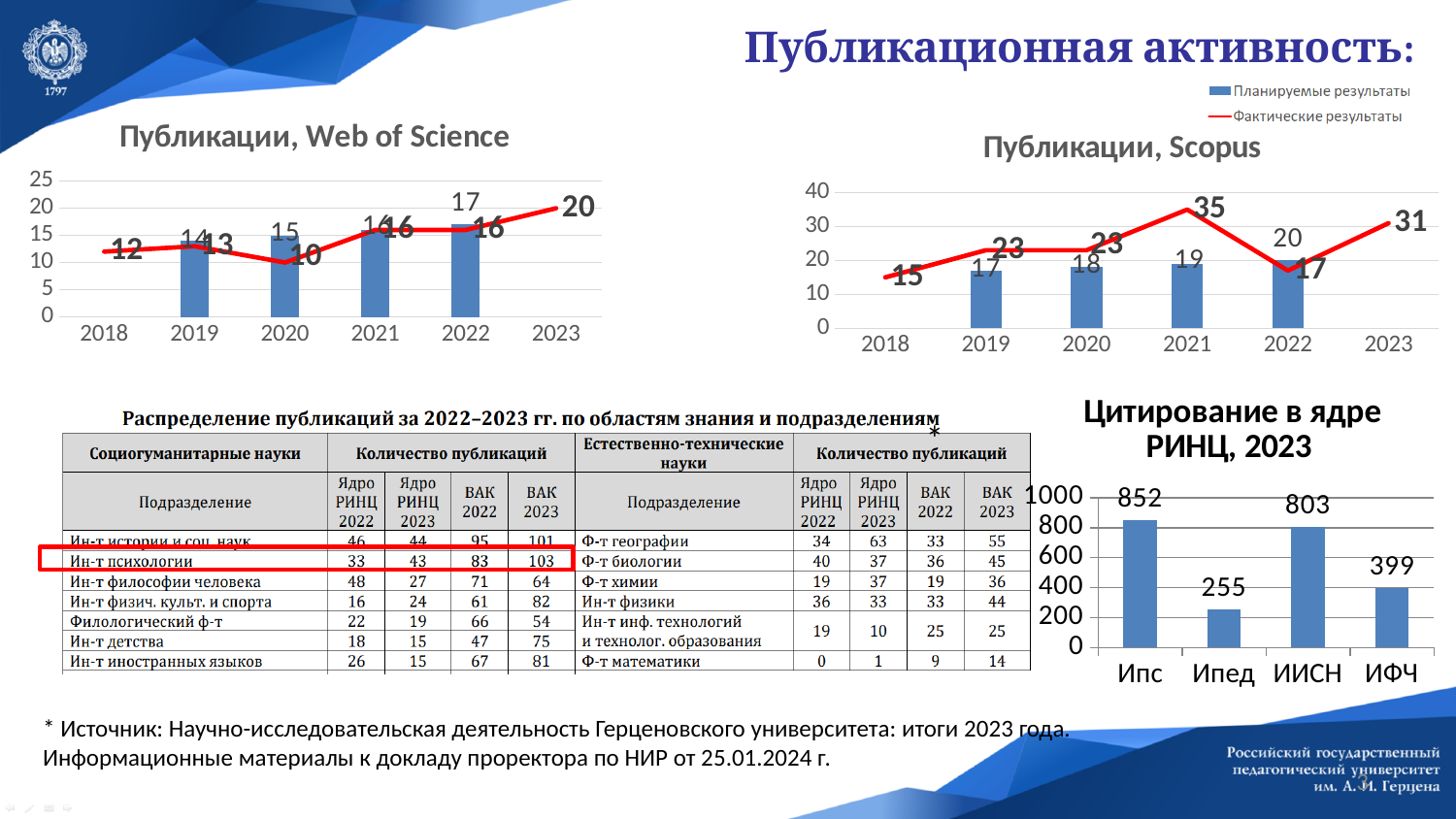
In the 'Публикации, Web of Science' chart, what is the actual result for 2020? 10 In the 'Публикации, Scopus' chart, what is the difference between the actual and planned results for 2021? 16 In the 'Цитирование в ядре РИНЦ, 2023' chart, what is the value for ИИСН? 803 In the 'Публикации, Web of Science' chart, what is the actual result (Фактические результаты) for 2023? 20 In the 'Публикации, Web of Science' chart, what is the planned result (Планируемые результаты) for 2022? 17 In the 'Публикации, Scopus' chart, what is the actual result for 2021? 35 In the 'Публикации, Web of Science' chart, which year has the lowest actual result? 2020 In the 'Публикации, Scopus' chart, which year has the highest actual result? 2021 In the 'Цитирование в ядре РИНЦ, 2023' chart, what is the difference between Ипс and Ипед? 597 In the 'Цитирование в ядре РИНЦ, 2023' chart, which category has the highest value? Ипс In the 'Публикации, Scopus' chart, what is the planned result for 2022? 20 In the 'Публикации, Scopus' chart, is the actual result for 2022 larger or smaller than the planned result for 2022? smaller